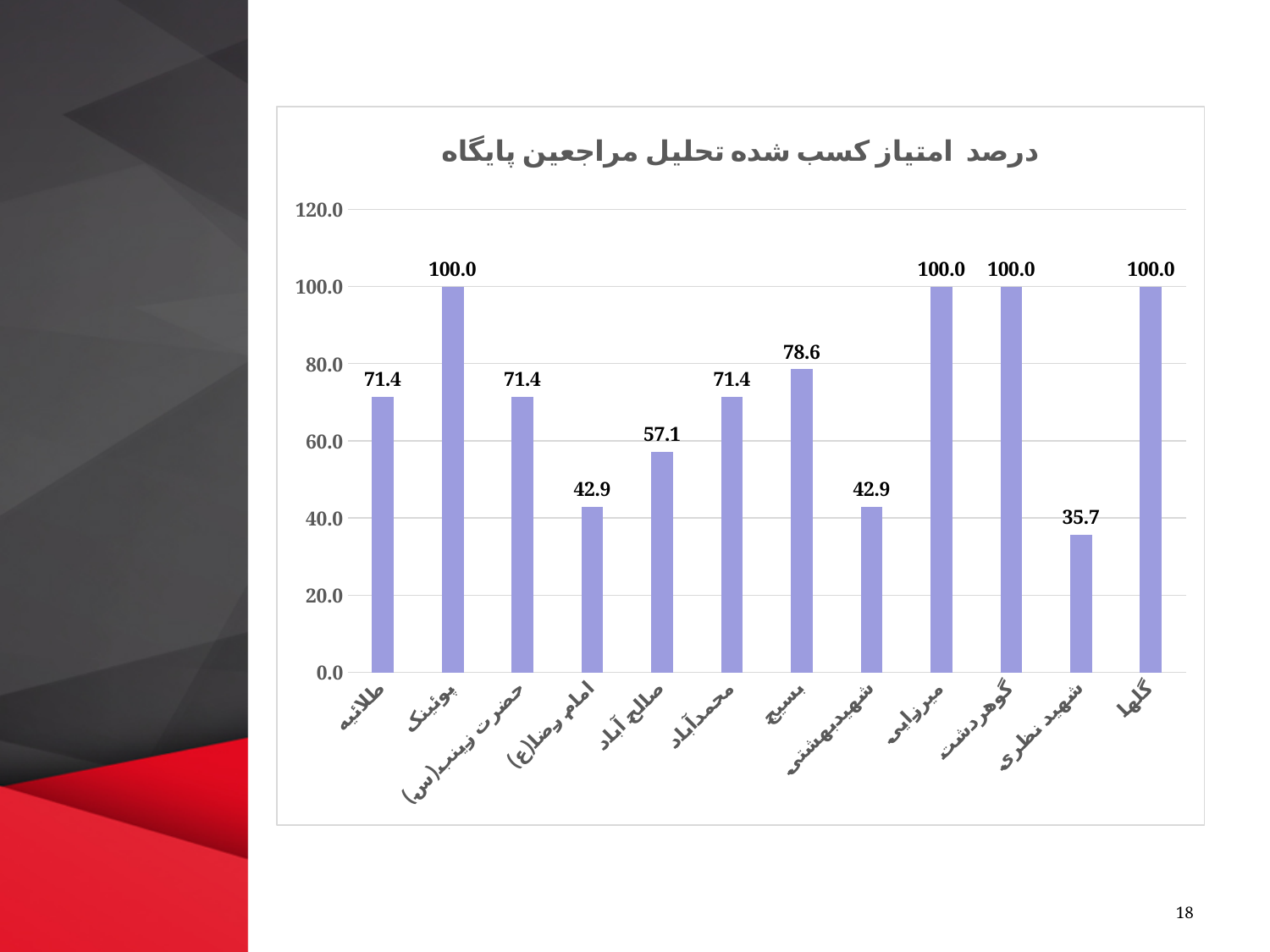
What is the difference between the values for بسیج and امام رضا(ع)? 35.7 What is the value for بسیج? 78.6 How many categories are shown on the x axis? 12 What is the value for شهید نظری? 35.7 Which category has the lowest value? شهید نظری What is the title of the chart? درصد امتیاز کسب شده تحلیل مراجعین پایگاه What is the value for صالح آباد? 57.1 Which is larger, the value for محمدآباد or the value for شهیدبهشتی? محمدآباد Is the value for گوهردشت greater or less than 80.0? greater How many categories have a value of 100.0? 4 What is the value for طلائیه? 71.4 What kind of chart is shown on the slide? bar chart